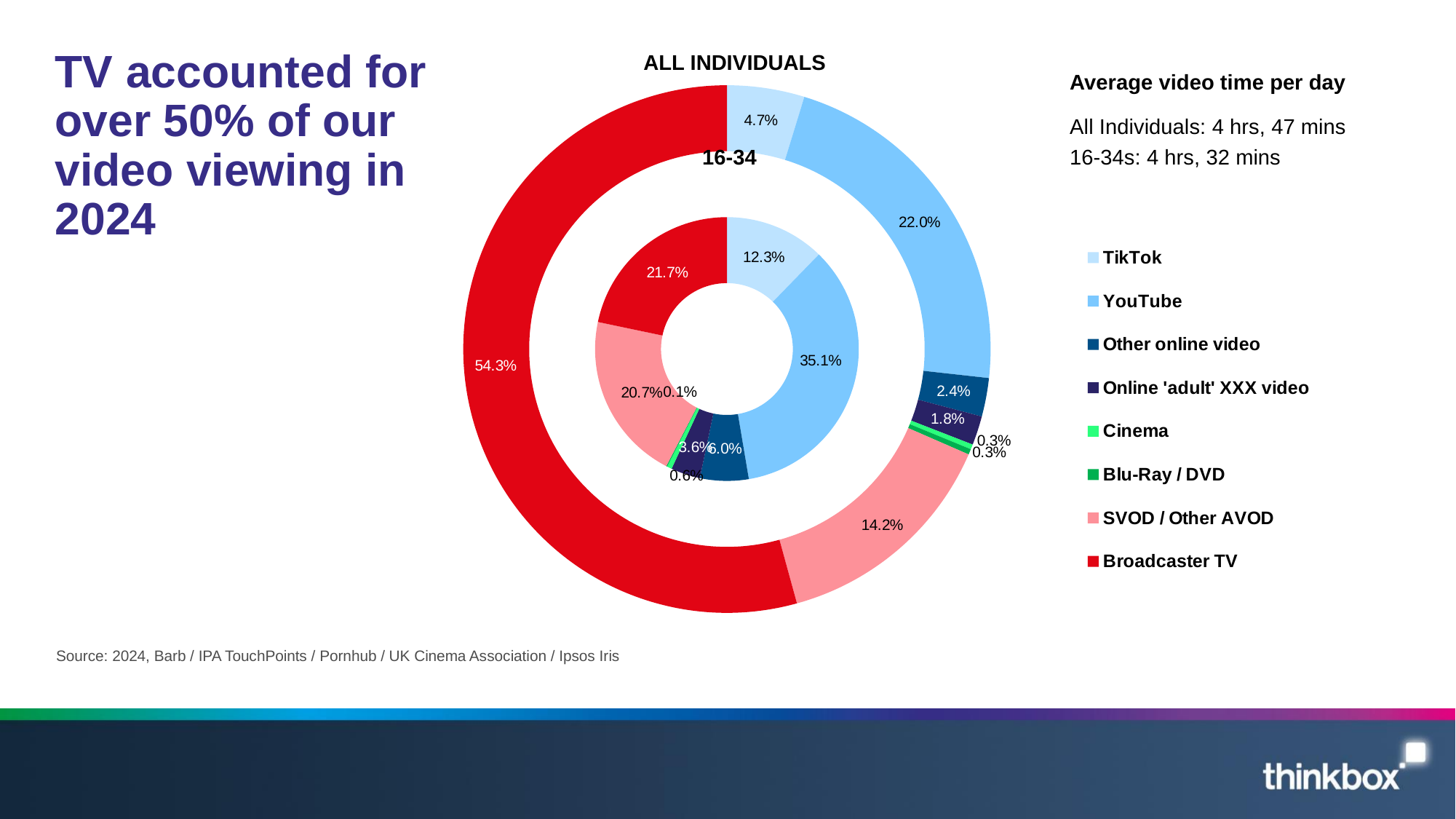
In the outer ring (All Individuals), what share of video viewing does Broadcaster TV account for? 54.3% In the outer ring (All Individuals), what is the value for YouTube? 22.0% In the inner ring (16-34), what is the value for SVOD / Other AVOD? 20.7% What is the title shown above the outer ring of the chart? ALL INDIVIDUALS In the inner ring (16-34), what is the value for YouTube? 35.1% What is the difference between the Broadcaster TV share for All Individuals (54.3%) and for 16-34s (21.7%)? 32.6% How many categories does the legend list? 8 In the inner ring (16-34), what is the value for TikTok? 12.3% Which category has the largest share in the inner ring (16-34)? YouTube What type of chart is shown on the slide? Doughnut chart Which category has the largest share in the outer ring (All Individuals)? Broadcaster TV In the inner ring (16-34), which is larger: Broadcaster TV or SVOD / Other AVOD? Broadcaster TV